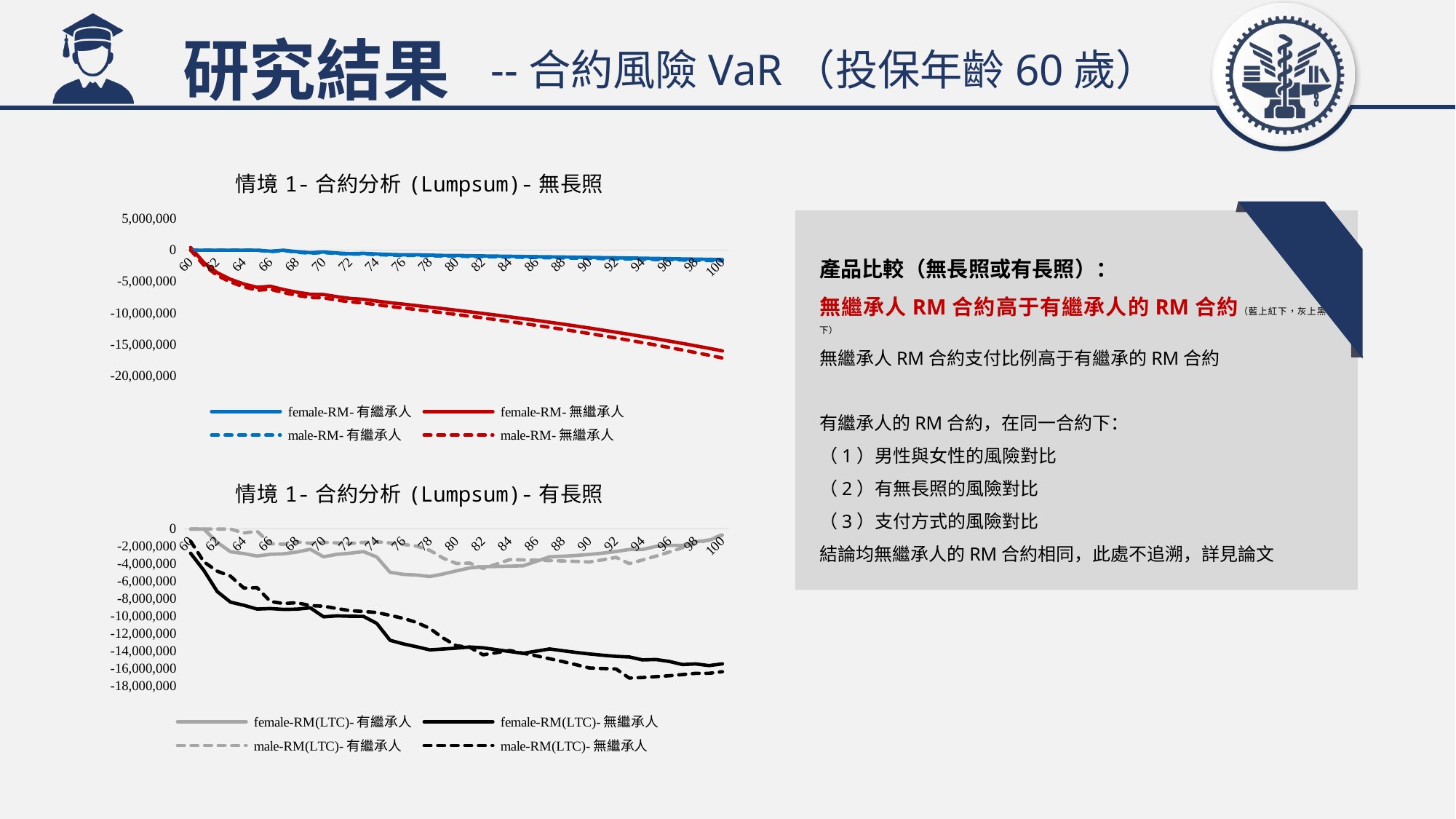
In the top chart (無長照), does the female-RM-無繼承人 line rise or fall as age increases from 60 to 100? fall How many series does the legend of the top chart (無長照) list? 4 In the top chart (無長照), at age 100, which is larger: female-RM-有繼承人 or female-RM-無繼承人? female-RM-有繼承人 In the top chart (無長照), what colour are the 無繼承人 lines? red What kind of chart is the top chart titled 情境 1- 合約分析（Lumpsum）- 無長照? line chart In the bottom chart (有長照), is the value for female-RM(LTC)-有繼承人 at age 100 greater or less than -4,000,000? greater How many series does the legend of the bottom chart (有長照) list? 4 In the top chart (無長照), is the value for female-RM-無繼承人 at age 100 greater or less than -15,000,000? less How many age labels are shown on the x axis of the top chart (無長照)? 21 In the bottom chart (有長照), does the female-RM(LTC)-無繼承人 line rise or fall as age increases from 60 to 100? fall In the top chart (無長照), is the value for female-RM-有繼承人 at age 100 greater or less than -5,000,000? greater